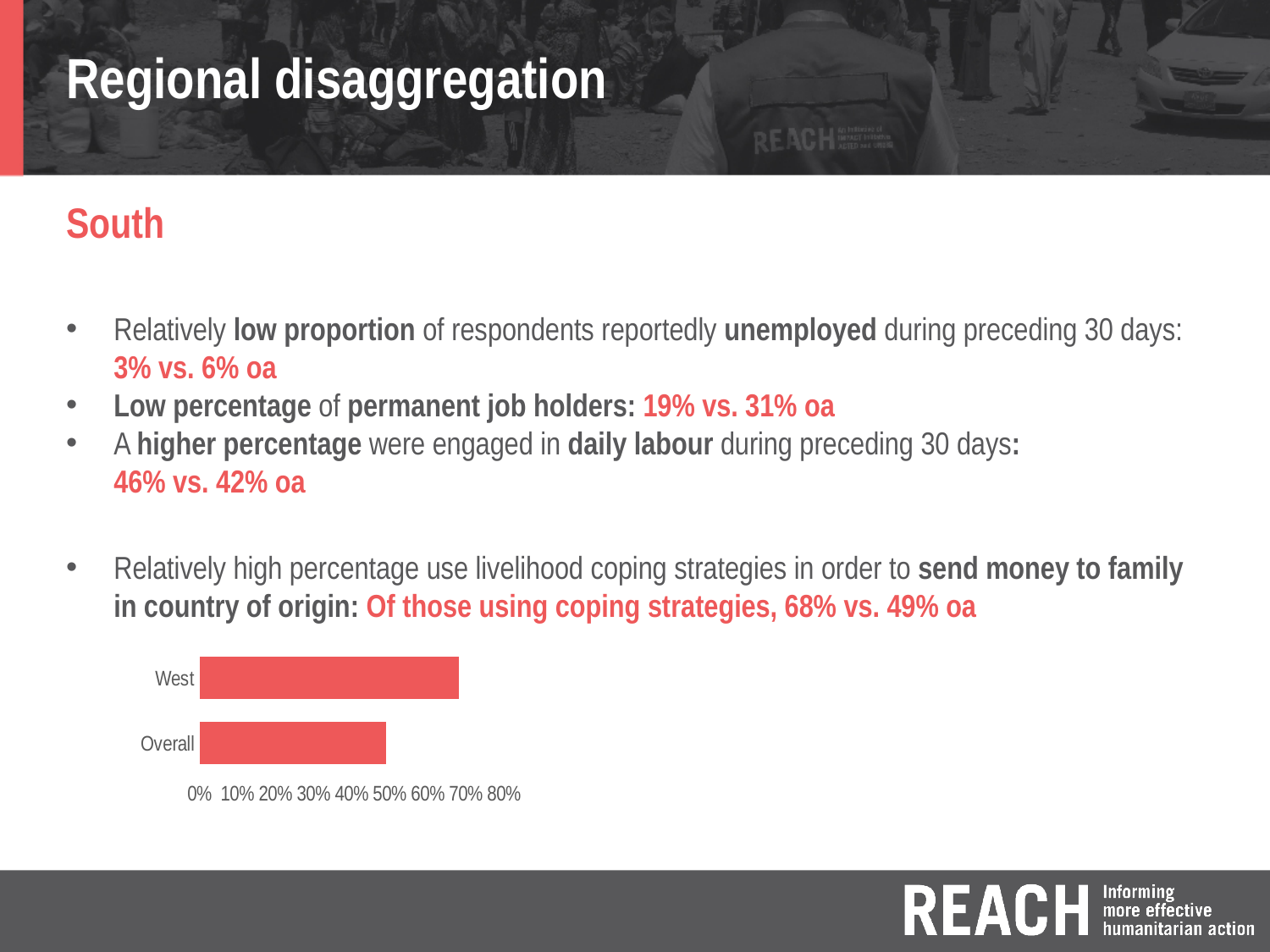
Is the value for Overall in the bar chart greater or less than 60%? less How many categories does the bar chart show? 2 Is the value for West in the bar chart greater or less than 80%? less Which category in the bar chart has the lowest value? Overall In the bar chart, is the value for West larger or smaller than the value for Overall? larger Is the value for Overall in the bar chart greater or less than 40%? greater What is the highest value shown on the x axis of the bar chart? 80% What are the two category labels on the bar chart, from top to bottom? West, Overall Which category in the bar chart has the highest value? West What kind of chart is shown at the bottom of the slide? bar chart